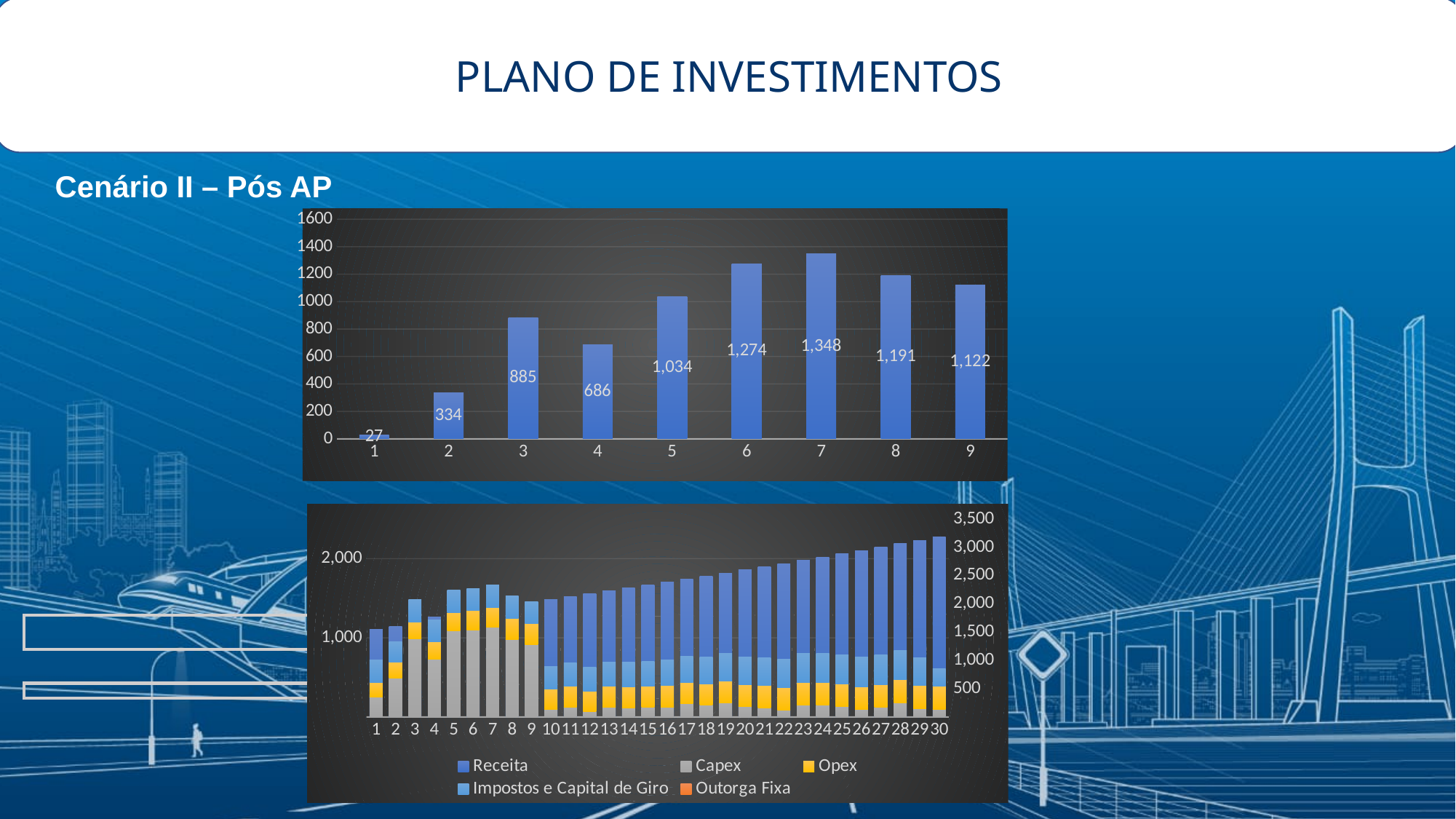
In the top chart, which is larger, the value for category 3 or the value for category 4? category 3 In the top chart, which category has the lowest value? 1 In the top chart, what is the value for category 7? 1,348 In the top chart, what is the difference between the values for category 6 and category 5? 240 In the bottom chart, how many series does the legend list? 5 In the top chart, how many categories are shown on the x axis? 9 In the top chart, what is the value for category 4? 686 In the bottom chart, how many categories are shown on the x axis? 30 In the top chart, what is the value for category 2? 334 In the bottom chart, is the total stacked value for category 30 greater or less than 3,000? greater In the top chart, which category has the highest value? 7 What kind of chart is the top chart? bar chart